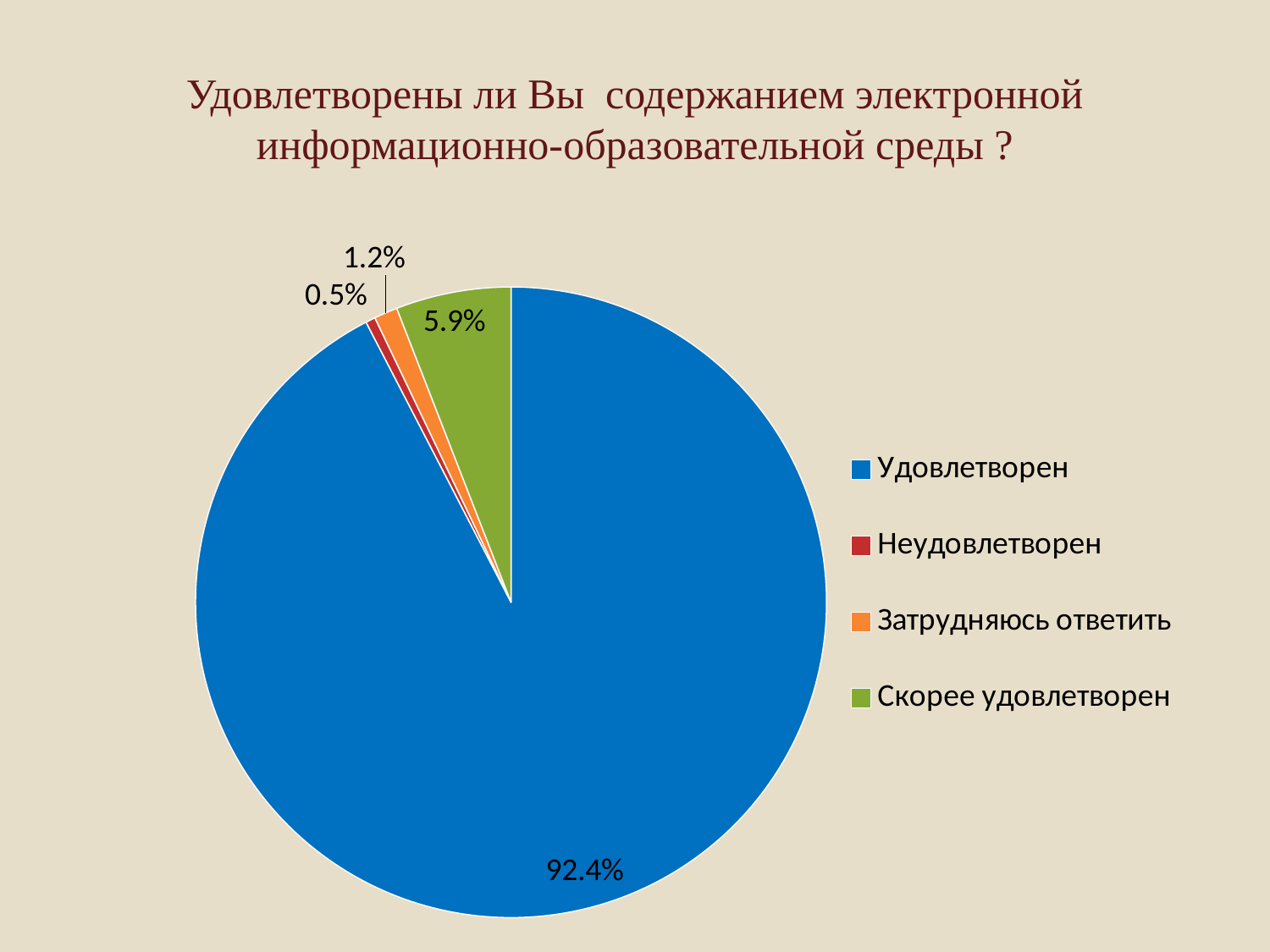
What share of respondents answered "Удовлетворен"? 92.4% What share of respondents answered "Неудовлетворен"? 0.5% Which is larger: the share for "Затрудняюсь ответить" or for "Неудовлетворен"? Затрудняюсь ответить Which answer has the largest slice of the pie? Удовлетворен How many slices does the pie chart have? 4 What share of respondents answered "Скорее удовлетворен"? 5.9% What is the difference in percentage points between "Удовлетворен" and "Скорее удовлетворен"? 86.5 Which answer has the smallest slice of the pie? Неудовлетворен What is the combined share of "Неудовлетворен" and "Затрудняюсь ответить"? 1.7% What colour is the slice for "Скорее удовлетворен"? Green What share of respondents answered "Затрудняюсь ответить"? 1.2% What kind of chart is shown on the slide? Pie chart